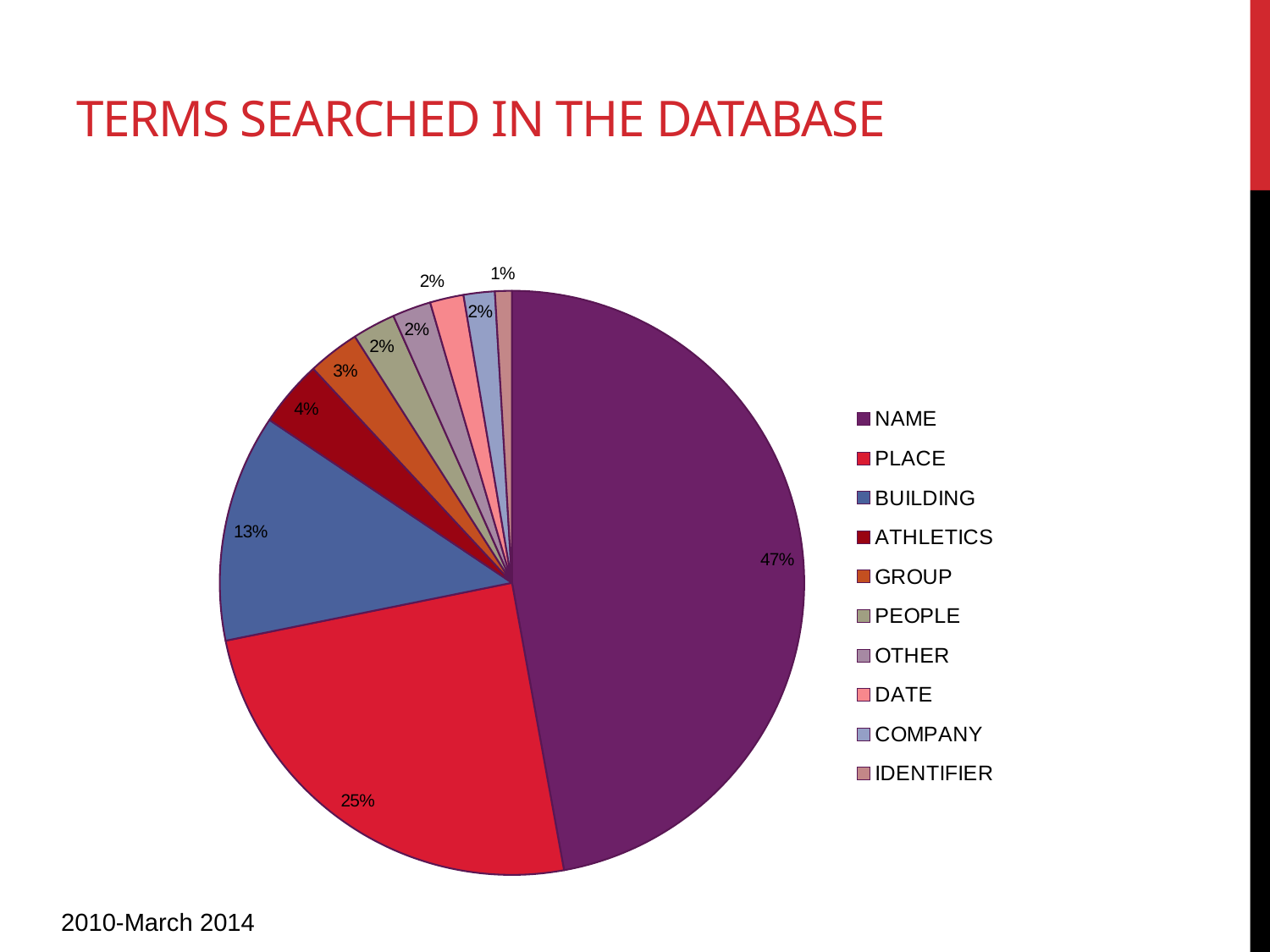
What share of the pie does GROUP account for? 3% What kind of chart is shown on the slide? Pie chart What share of the pie does BUILDING account for? 13% Which category has the largest slice of the pie? NAME What share of the pie does PLACE account for? 25% Which category has the smallest slice of the pie? IDENTIFIER How many categories does the legend list? 10 What is the difference in percentage points between the NAME and PLACE slices? 22 Which is larger, the BUILDING slice or the ATHLETICS slice? BUILDING